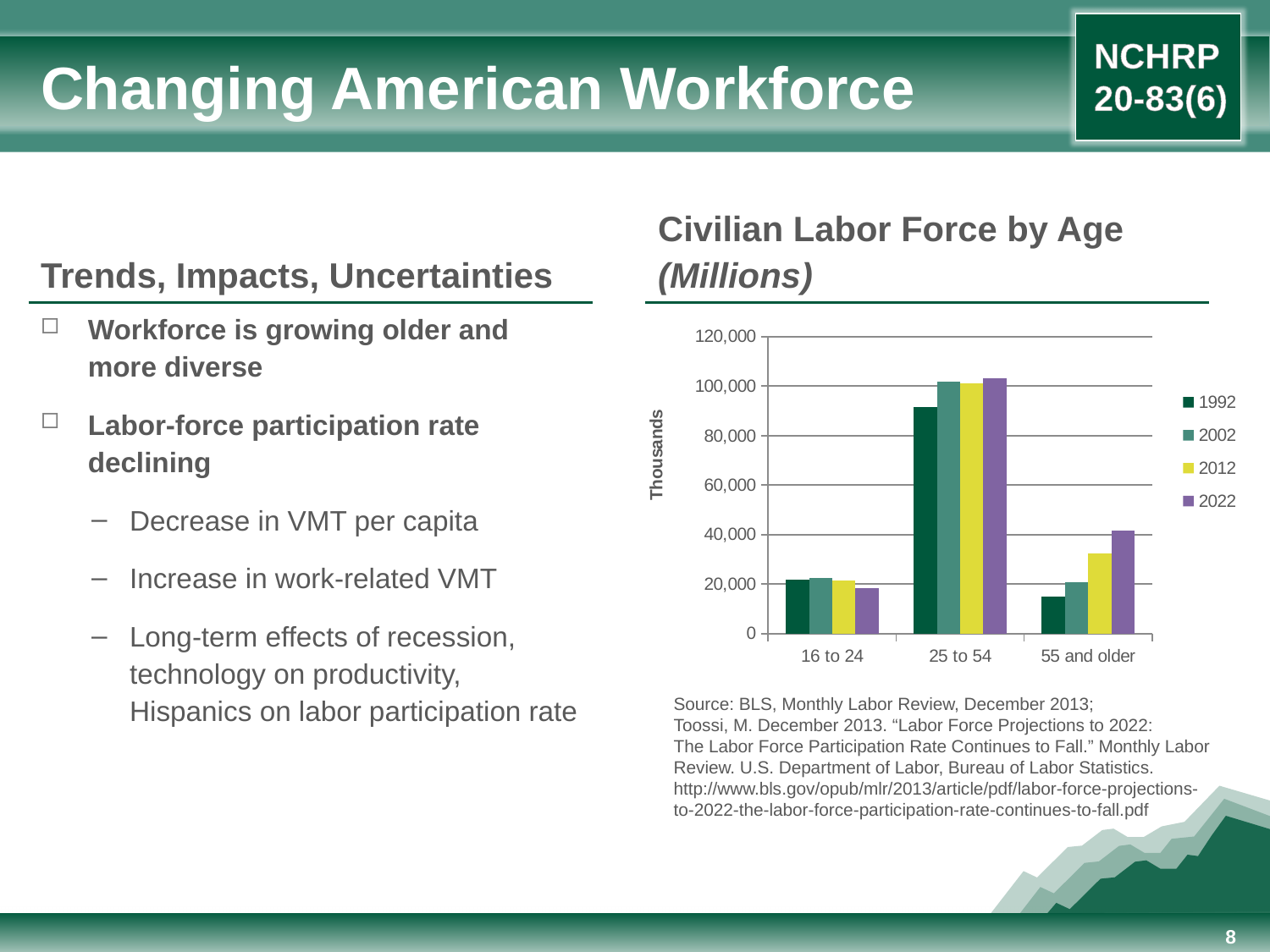
Is the value for 16 to 24 in 2022 greater or less than 20,000? less Is the value for 55 and older in 2022 greater or less than 40,000? greater Which age category has the lowest value for 1992? 55 and older What is the label on the vertical axis of the chart? Thousands How many age categories are shown on the x axis of the chart? 3 For the 55 and older category, which is larger: the 2012 value or the 2022 value? 2022 What kind of chart is shown on the slide? bar chart Is the value for 25 to 54 in 1992 greater or less than 100,000? less Which age category has the highest values in the chart? 25 to 54 For the 55 and older category, do the values rise or fall from 1992 to 2022? rise How many series does the chart's legend list? 4